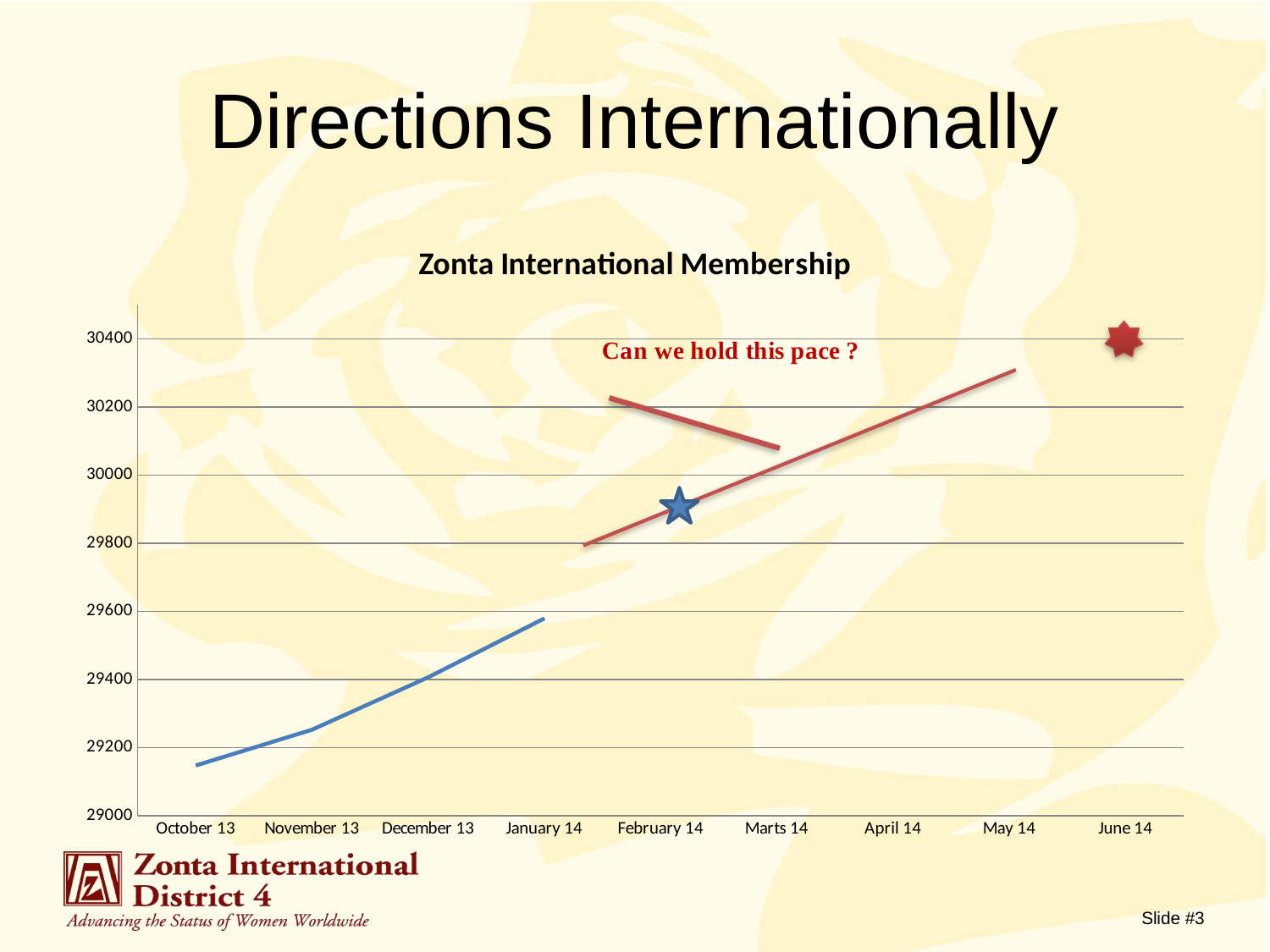
Which is larger, the value for November 13 or the value for December 13? December 13 Is the value for December 13 greater or less than 29200? greater Which plotted month has the highest membership value? January 14 What kind of chart is shown on the slide? line chart Does the plotted membership line rise or fall from October 13 to January 14? rises How many month categories are listed along the x axis? 9 What question is written in red text above the chart's lines? Can we hold this pace ? Which plotted month has the lowest membership value? October 13 Is the value for January 14 greater or less than 29400? greater What is the title of the chart? Zonta International Membership Is the value for October 13 greater or less than 29200? less